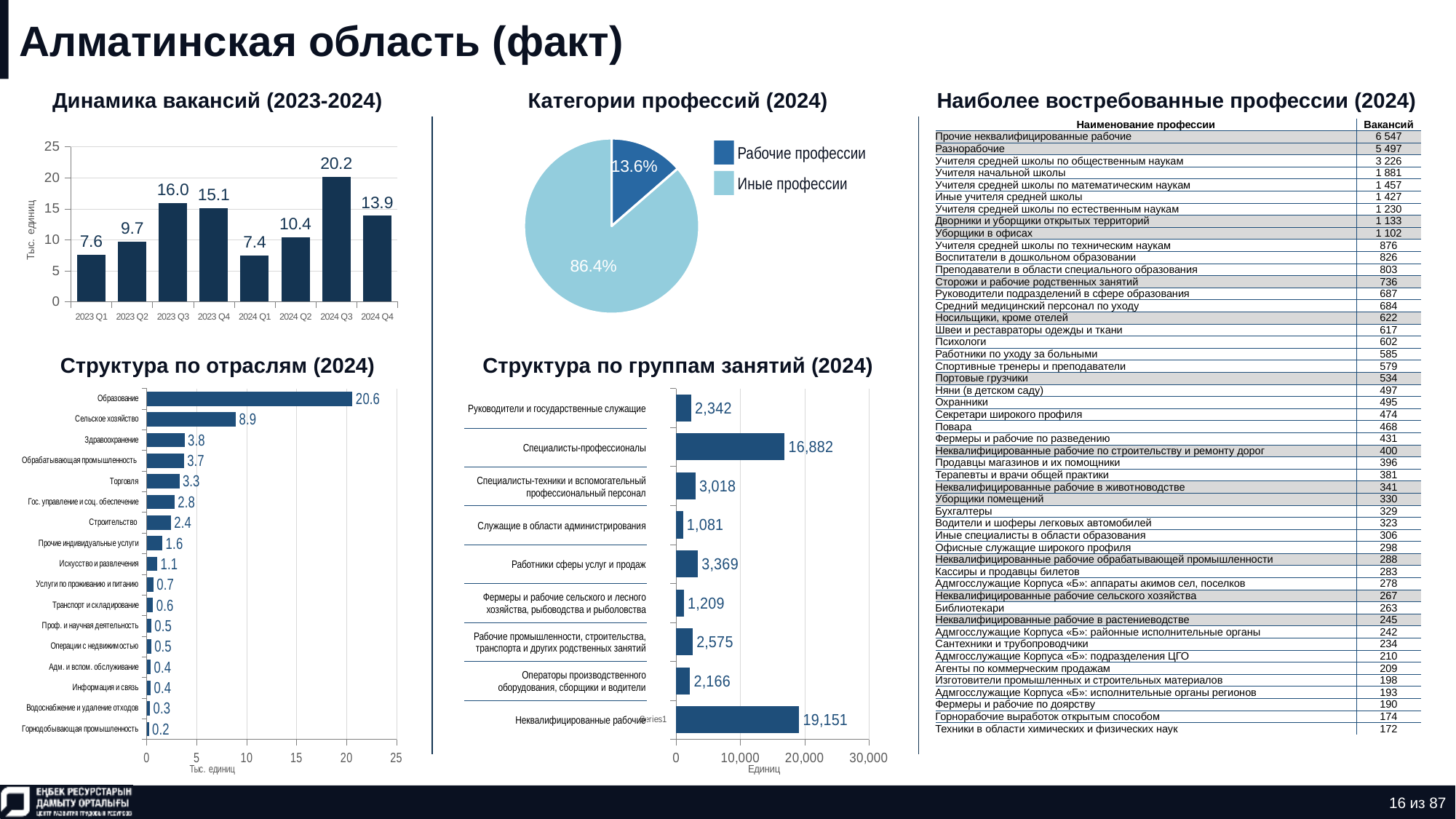
In the chart 'Динамика вакансий (2023-2024)', what is the difference between 2023 Q3 and 2023 Q2? 6.3 In the chart 'Динамика вакансий (2023-2024)', how many quarters are plotted? 8 In the chart 'Структура по отраслям (2024)', which is larger: 'Здравоохранение' or 'Торговля'? Здравоохранение In the chart 'Структура по отраслям (2024)', what is the value for 'Сельское хозяйство'? 8.9 In the chart 'Категории профессий (2024)', what share of the pie is 'Рабочие профессии'? 13.6% In the chart 'Динамика вакансий (2023-2024)', which quarter has the lowest value? 2024 Q1 In the chart 'Структура по группам занятий (2024)', which category has the highest value? Неквалифицированные рабочие In the chart 'Структура по группам занятий (2024)', what is the difference between 'Работники сферы услуг и продаж' and 'Служащие в области администрирования'? 2,288 In the chart 'Структура по группам занятий (2024)', what is the value for 'Специалисты-профессионалы'? 16,882 In the chart 'Структура по отраслям (2024)', which category has the highest value? Образование In the chart 'Динамика вакансий (2023-2024)', what is the value for 2024 Q3? 20.2 What kind of chart is 'Категории профессий (2024)'? Pie chart